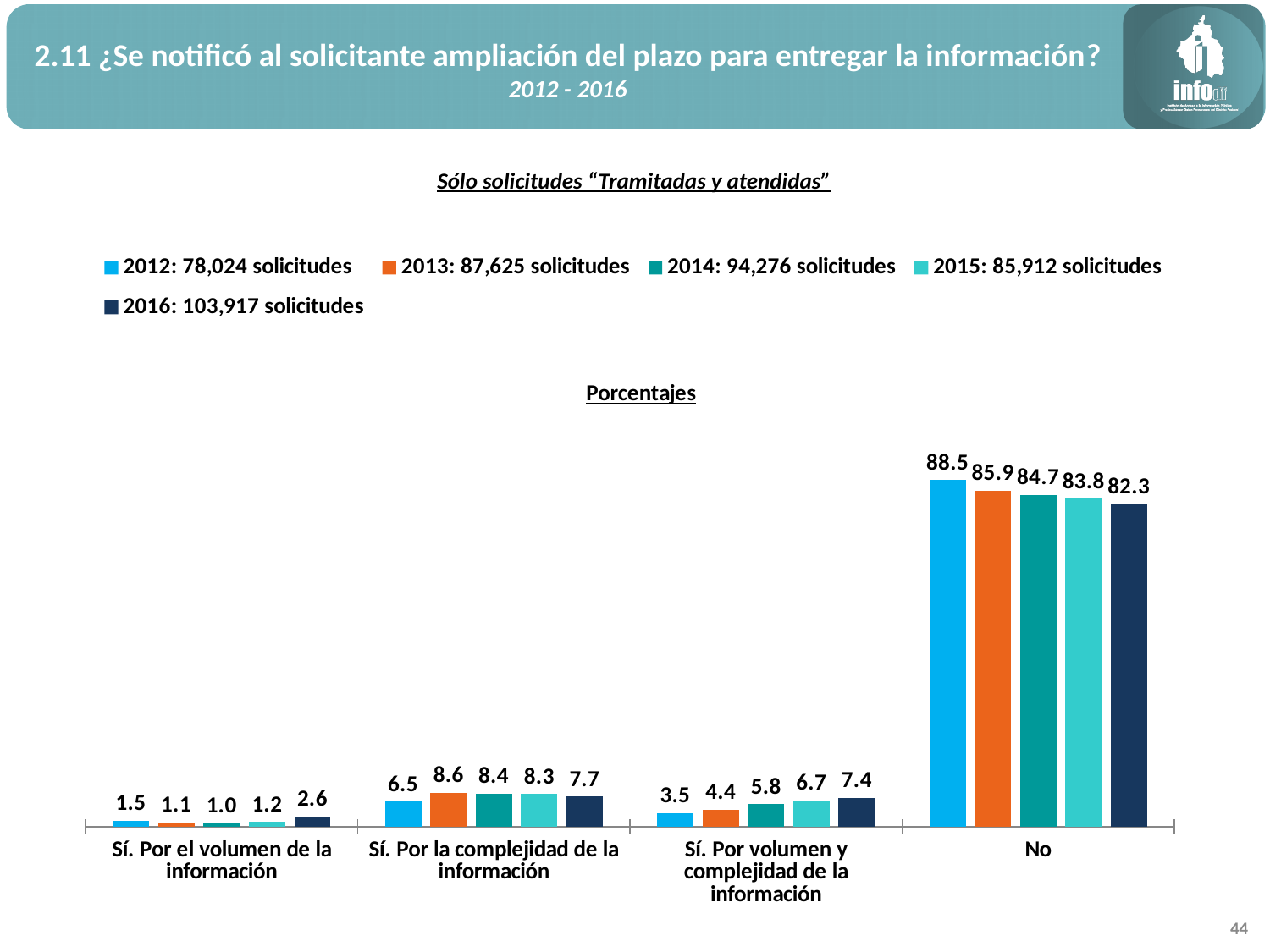
What kind of chart is shown on the slide? Bar chart What is the value for 2012 in the "No" category? 88.5 What is the value for 2015 in the "Sí. Por volumen y complejidad de la información" category? 6.7 What is the difference between the 2012 and 2016 values in the "No" category? 6.2 What is the value for 2016 in the "Sí. Por el volumen de la información" category? 2.6 Which year has the lowest value in the "No" category? 2016 How many categories are shown on the x axis? 4 How many series does the legend list? 5 Which is larger: the 2012 value or the 2013 value in the "Sí. Por la complejidad de la información" category? 2013 What is the value for 2013 in the "Sí. Por la complejidad de la información" category? 8.6 Do the values in the "No" category rise or fall from 2012 to 2016? Fall Which year has the highest value in the "Sí. Por volumen y complejidad de la información" category? 2016